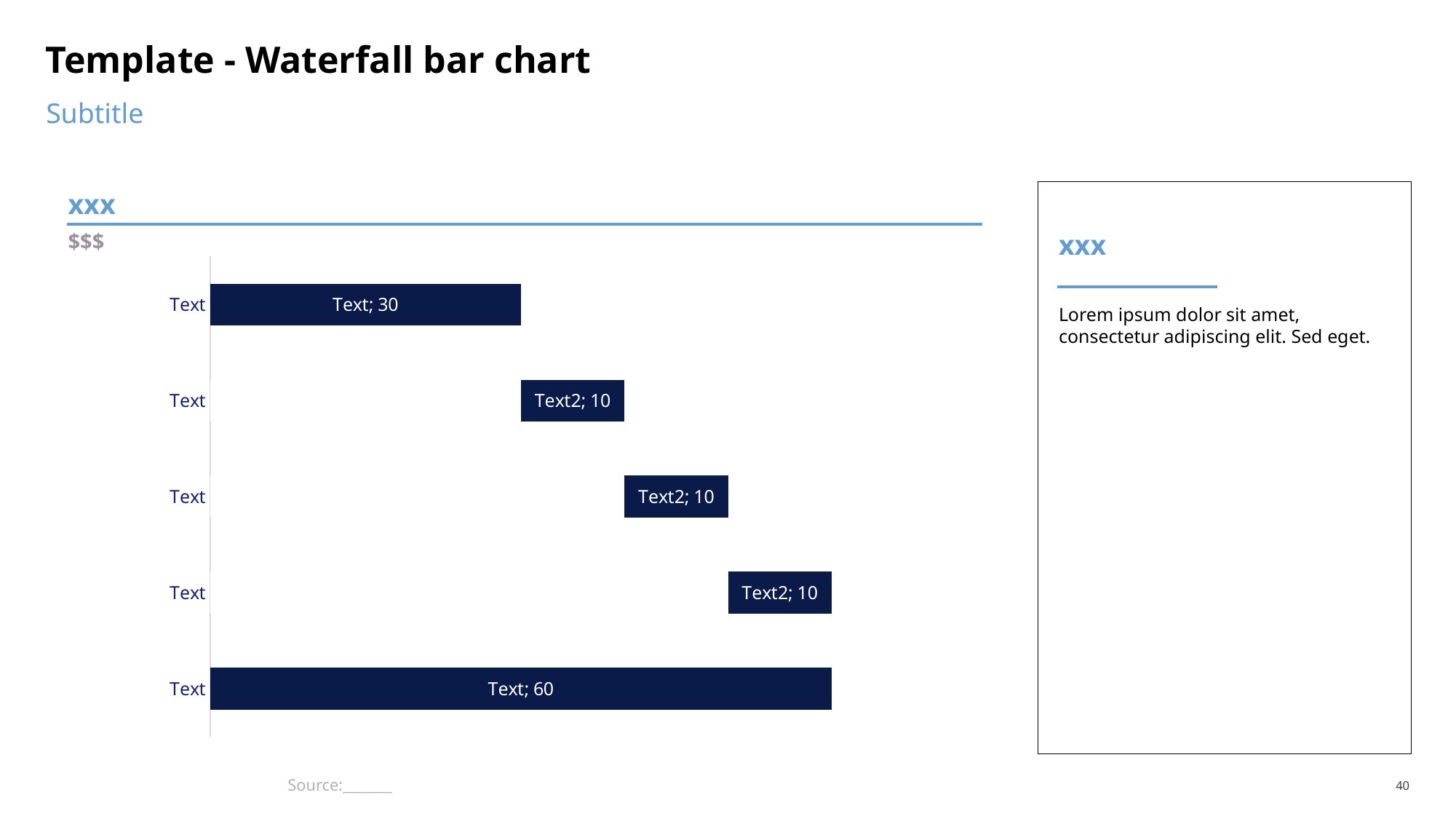
Which bar has the highest value? the bottom bar (60) How many bars carry the label "Text2; 10"? 3 What is the value shown on the second bar from the top? 10 What is the difference between the top bar's value and the second bar's value? 20 How many bars does the chart contain? 5 What is the highest value shown in the chart? 60 What kind of chart is shown on the slide? bar chart What is the difference between the bottom bar's value and the top bar's value? 30 What is the value shown on the bottom bar of the chart? 60 What is the title shown above the chart? XXX What is the value shown on the top bar of the chart? 30 Which is larger, the value of the top bar or the value of the bottom bar? the bottom bar